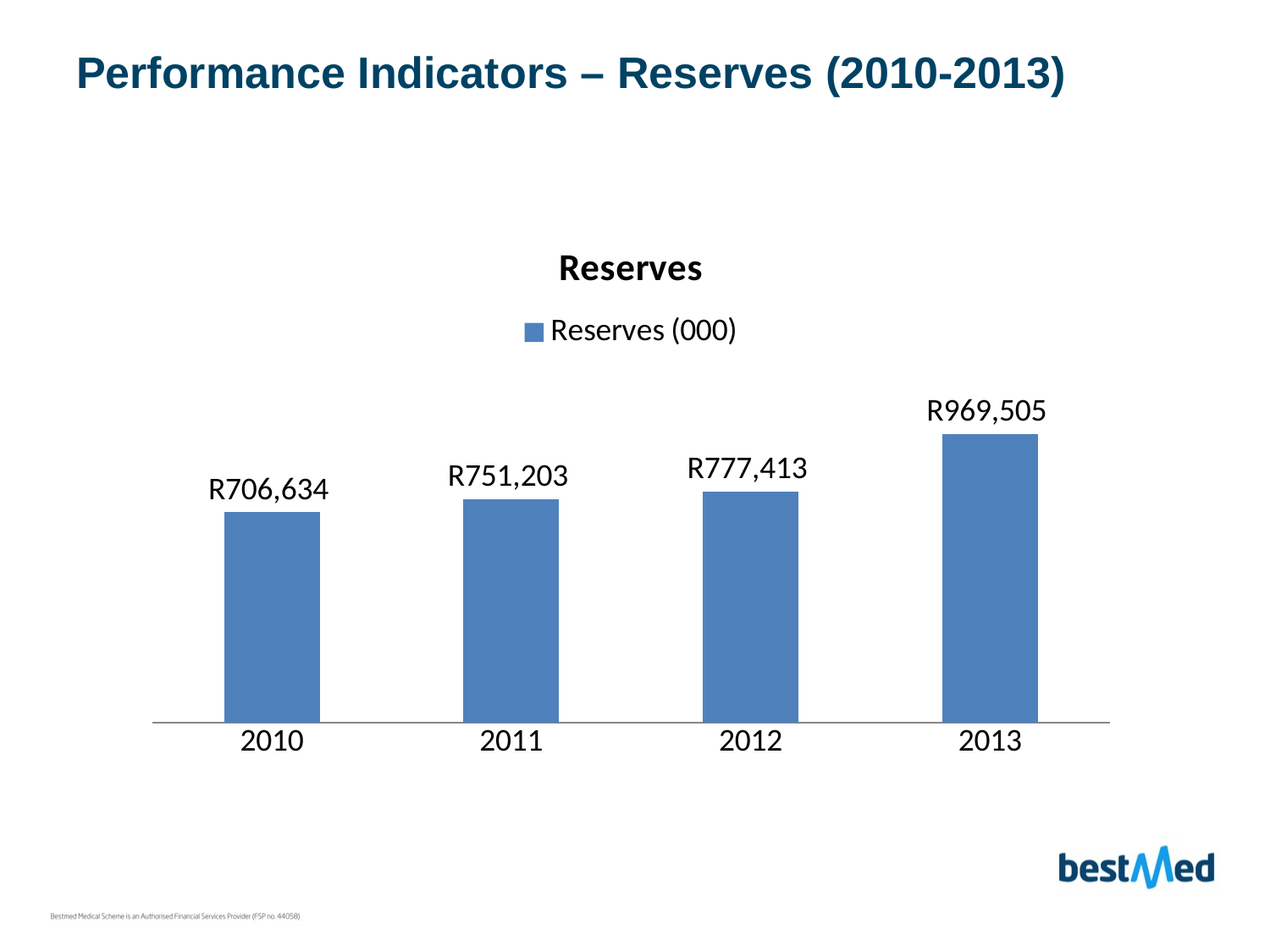
What is the value of Reserves (000) for 2012? R777,413 Do the reserves rise or fall from 2010 to 2013? Rise What is the difference between the reserves for 2011 and 2010? R44,569 Which year has the lowest reserves? 2010 What is the value of Reserves (000) for 2010? R706,634 Which year has the highest reserves? 2013 What is the difference between the reserves for 2013 and 2010? R262,871 How many series does the legend list? 1 Which year has larger reserves, 2011 or 2012? 2012 What kind of chart is shown on the slide? Bar chart How many years are shown on the x axis of the chart? 4 What is the value of Reserves (000) for 2013? R969,505